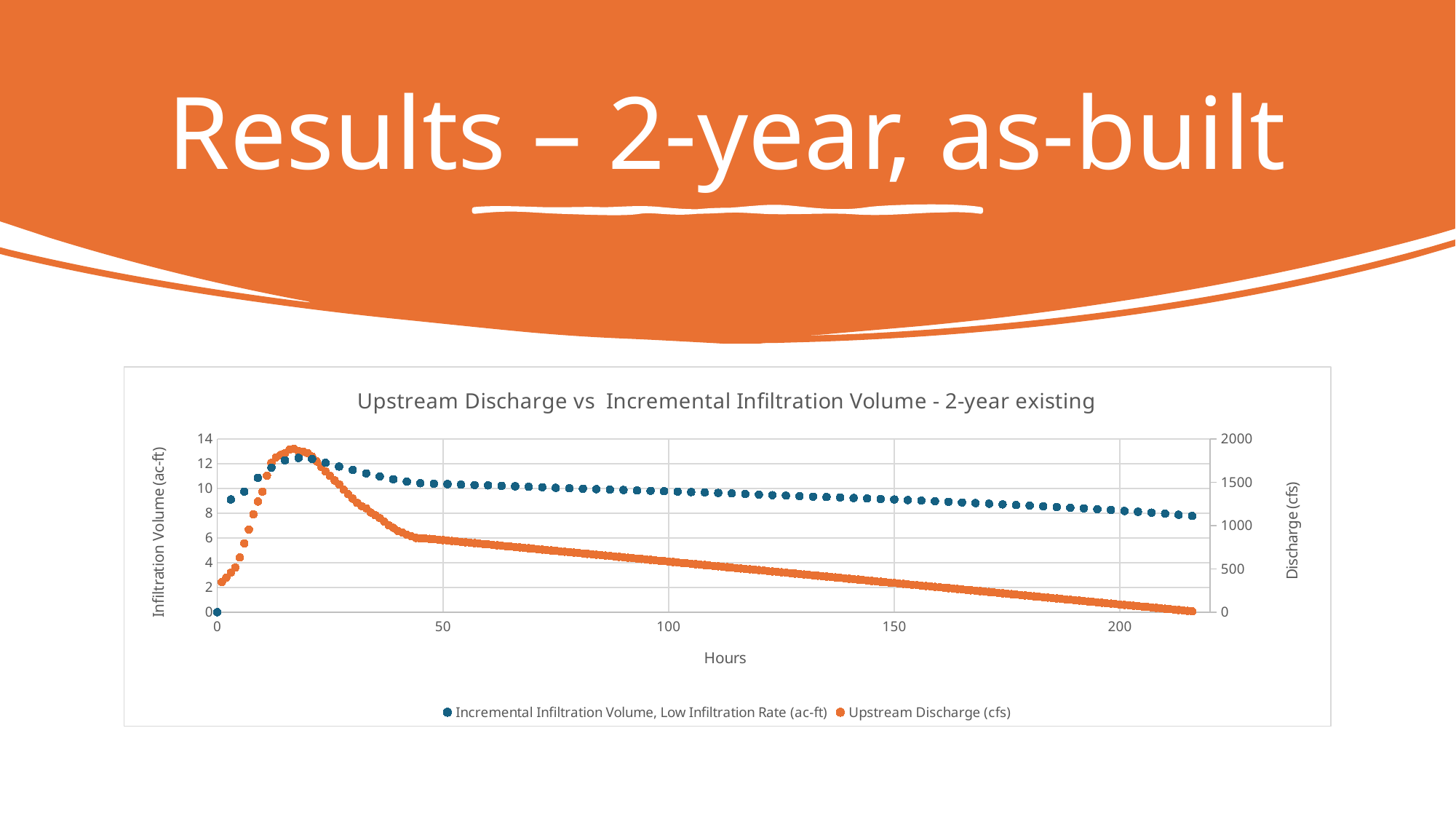
Is the Upstream Discharge (cfs) value at 150 hours greater or less than 500? less Is the peak value of the Incremental Infiltration Volume series greater or less than 10 ac-ft? greater Between 50 and 200 hours, does the Upstream Discharge (cfs) series rise or fall? fall How many series does the chart's legend list? 2 What is the label of the chart's x axis? Hours What is the title of the chart? Upstream Discharge vs Incremental Infiltration Volume - 2-year existing Is the Incremental Infiltration Volume value at 150 hours greater or less than 10 ac-ft? less What kind of chart is shown on the slide? Scatter chart Between 50 and 200 hours, does the Incremental Infiltration Volume series rise or fall? fall